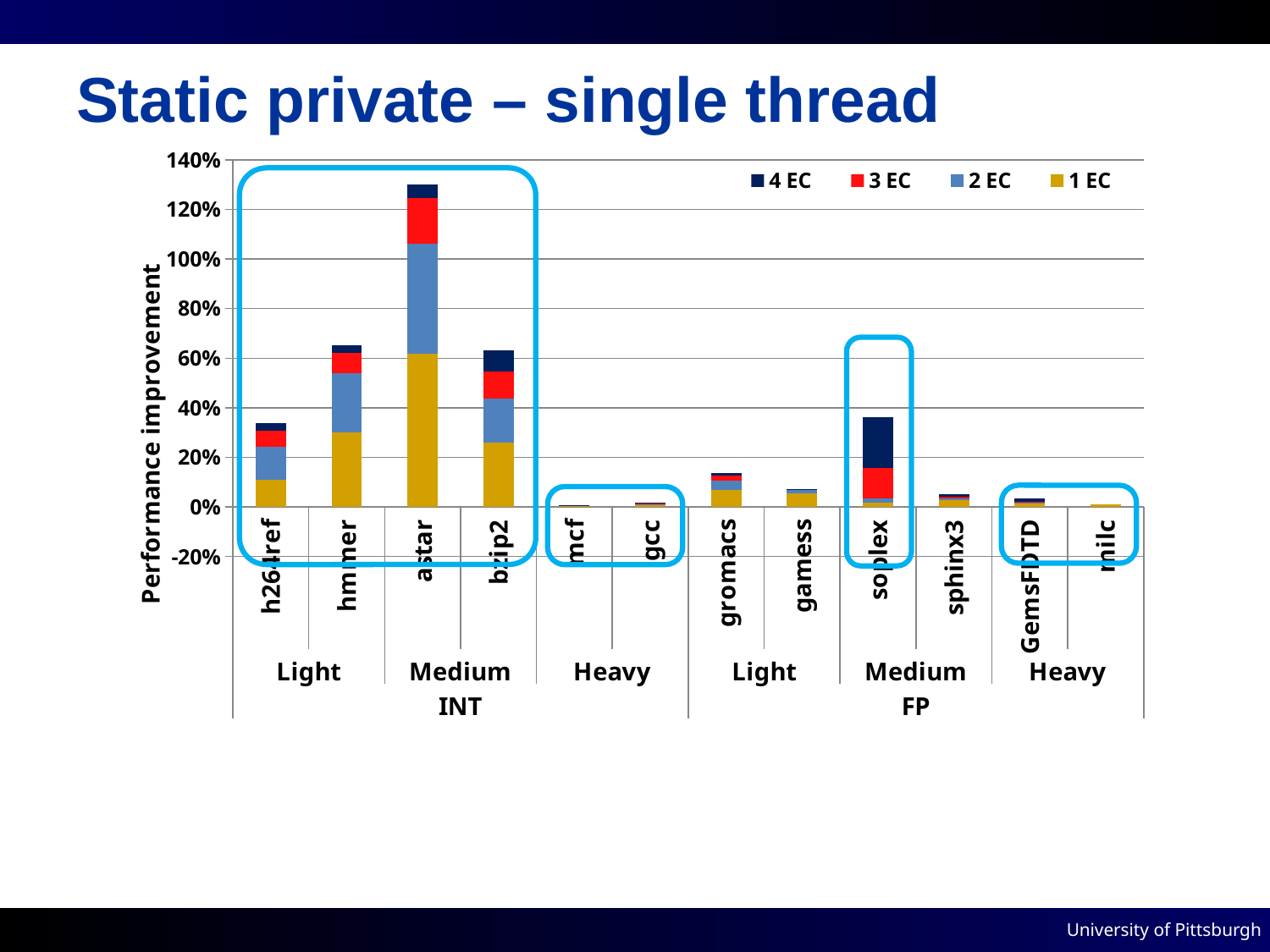
How many series does the legend list? 4 What kind of chart is shown on the slide? stacked bar chart Is the total performance improvement for hmmer greater or less than 60%? greater Is the total performance improvement for mcf greater or less than 20%? less Is the total performance improvement for h264ref greater or less than 20%? greater What is the label of the y axis? Performance improvement Which has a larger total performance improvement, soplex or gromacs? soplex Which has a larger total performance improvement, astar or hmmer? astar Which benchmark has the highest total performance improvement? astar How many benchmark categories are plotted along the x axis? 12